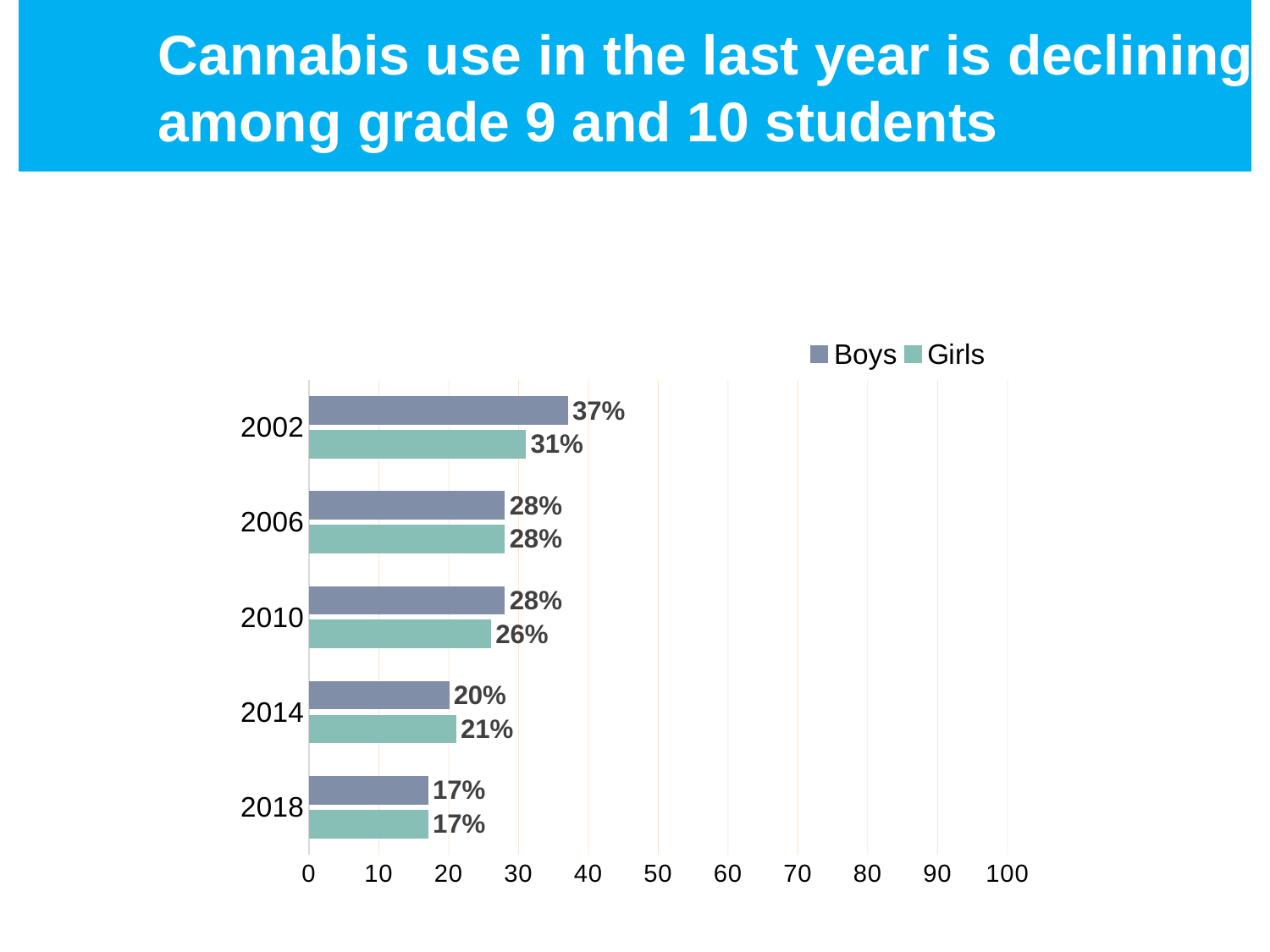
Which year has the highest value for Boys? 2002 What is the difference between the Boys and Girls values in 2002? 6% What kind of chart is shown on the slide? Bar chart What is the value for Girls in 2014? 21% Which is larger in 2014, the value for Boys or for Girls? Girls Do the Boys values rise or fall from 2002 to 2018? Fall What is the value for Boys in 2002? 37% What is the value for Girls in 2010? 26% What are the two series listed in the legend? Boys and Girls How many years are shown on the chart? 5 How many series does the legend list? 2 Which year has the lowest value for Girls? 2018